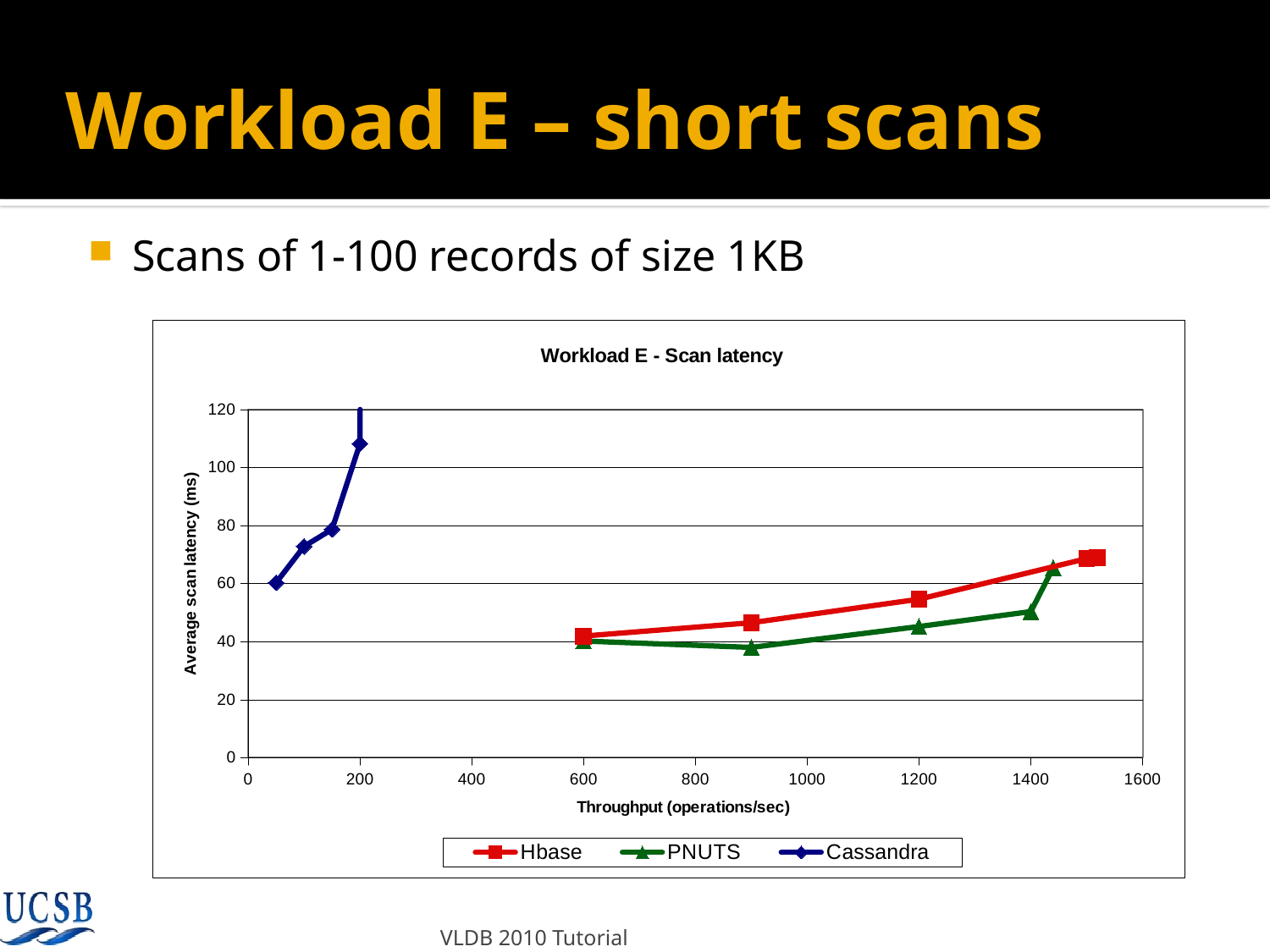
Does the Cassandra scan latency rise or fall as throughput increases? rise What is the label of the y axis? Average scan latency (ms) How many series does the legend list? 3 Which series reaches the highest average scan latency? Cassandra What is the title of the chart? Workload E - Scan latency Is the Cassandra scan latency at a throughput of about 200 operations/sec greater or less than 100 ms? greater What kind of chart is shown on the slide? line chart Which series reaches the highest throughput? Hbase At a throughput of about 1200 operations/sec, which series has the higher scan latency, Hbase or PNUTS? Hbase Does the Hbase scan latency rise or fall as throughput increases from 600 to 1500 operations/sec? rise Is the PNUTS scan latency at a throughput of about 1200 operations/sec greater or less than 60 ms? less Is the Hbase scan latency at a throughput of about 1500 operations/sec greater or less than 60 ms? greater